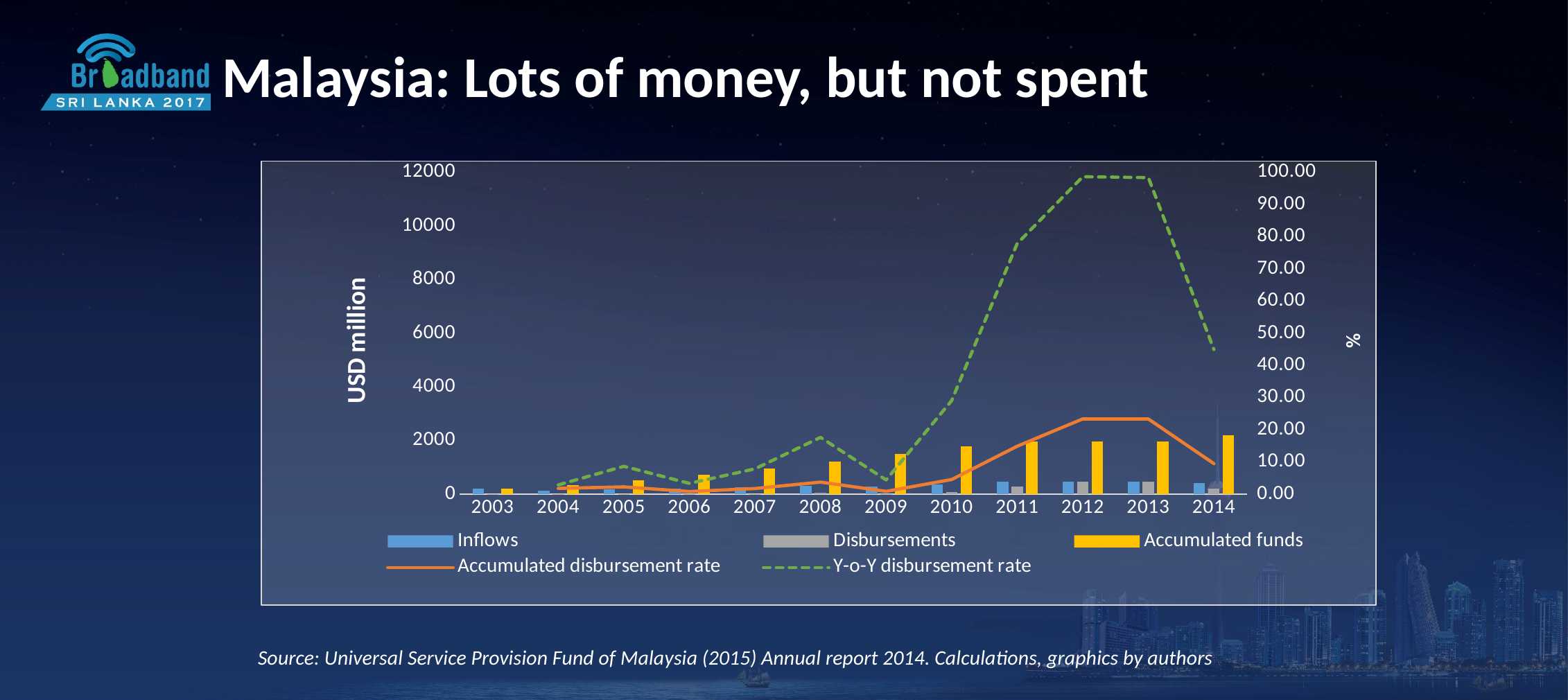
Is the value of Accumulated funds in 2009 greater or less than 1000? greater In which year are Accumulated funds lowest? 2003 Is the value of Accumulated funds in 2010 greater or less than 2000? less How many series does the chart's legend list? 5 Which is larger in 2011, Inflows or Disbursements? Inflows Does the Y-o-Y disbursement rate rise or fall from 2009 to 2012? rise What is the label of the left vertical axis? USD million How many years are shown on the x axis of the chart? 12 What kind of chart is shown on the slide? A combined bar and line chart Is the Accumulated disbursement rate in 2012 greater or less than 30.00? less Which series is drawn as a dashed green line? Y-o-Y disbursement rate